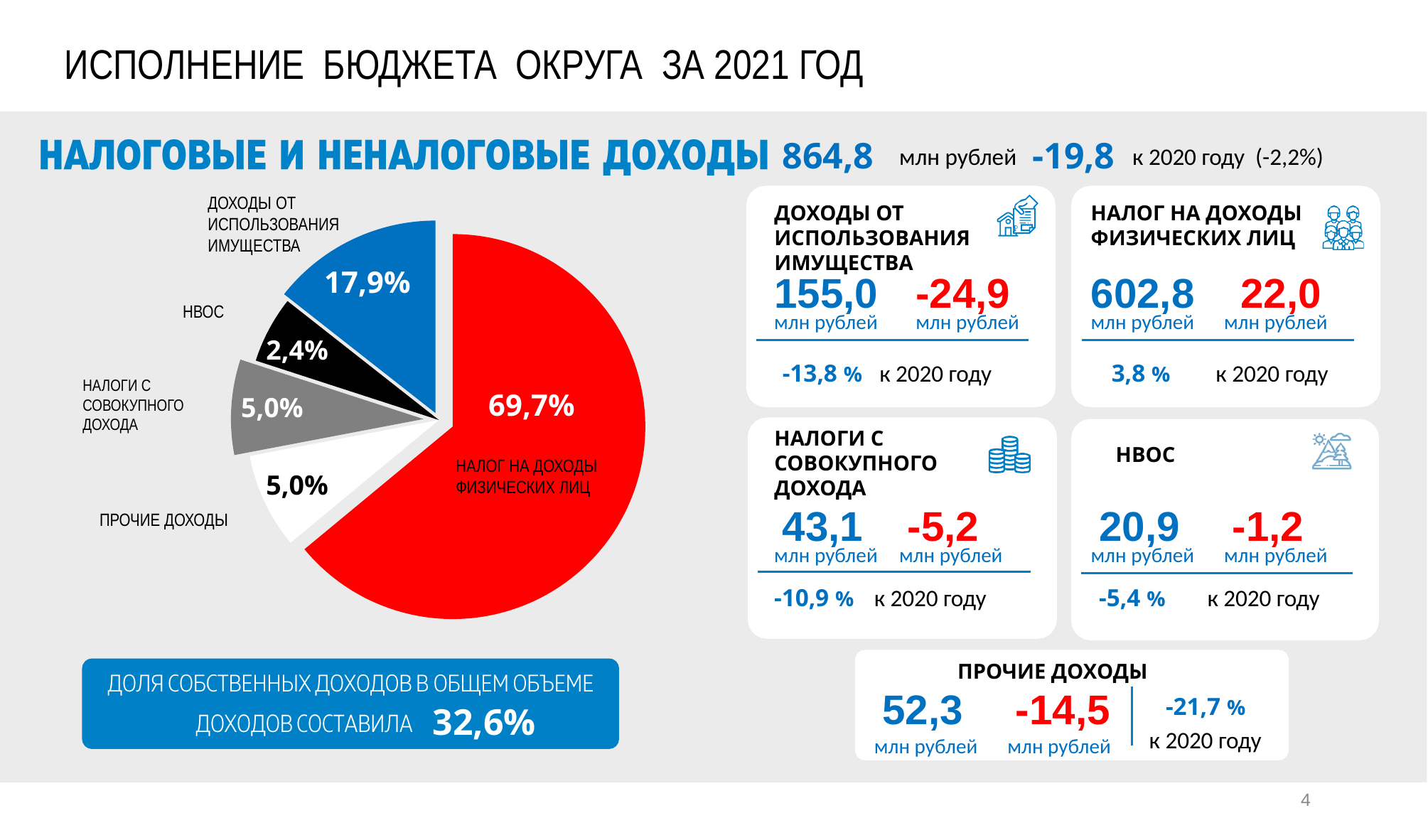
Which slice is larger: ДОХОДЫ ОТ ИСПОЛЬЗОВАНИЯ ИМУЩЕСТВА or НВОС? ДОХОДЫ ОТ ИСПОЛЬЗОВАНИЯ ИМУЩЕСТВА Which slice of the pie chart is the largest? НАЛОГ НА ДОХОДЫ ФИЗИЧЕСКИХ ЛИЦ How many slices does the pie chart have? 5 What share of the pie chart is НАЛОГ НА ДОХОДЫ ФИЗИЧЕСКИХ ЛИЦ? 69,7% What share of the pie chart is ПРОЧИЕ ДОХОДЫ? 5,0% What share of the pie chart is ДОХОДЫ ОТ ИСПОЛЬЗОВАНИЯ ИМУЩЕСТВА? 17,9% What colour is the НАЛОГ НА ДОХОДЫ ФИЗИЧЕСКИХ ЛИЦ slice in the pie chart? Red What is the difference in percentage points between the НАЛОГ НА ДОХОДЫ ФИЗИЧЕСКИХ ЛИЦ slice and the ДОХОДЫ ОТ ИСПОЛЬЗОВАНИЯ ИМУЩЕСТВА slice? 51,8 What type of chart is shown on the slide? Pie chart Which slice of the pie chart is the smallest? НВОС What share of the pie chart is НАЛОГИ С СОВОКУПНОГО ДОХОДА? 5,0% What share of the pie chart is НВОС? 2,4%